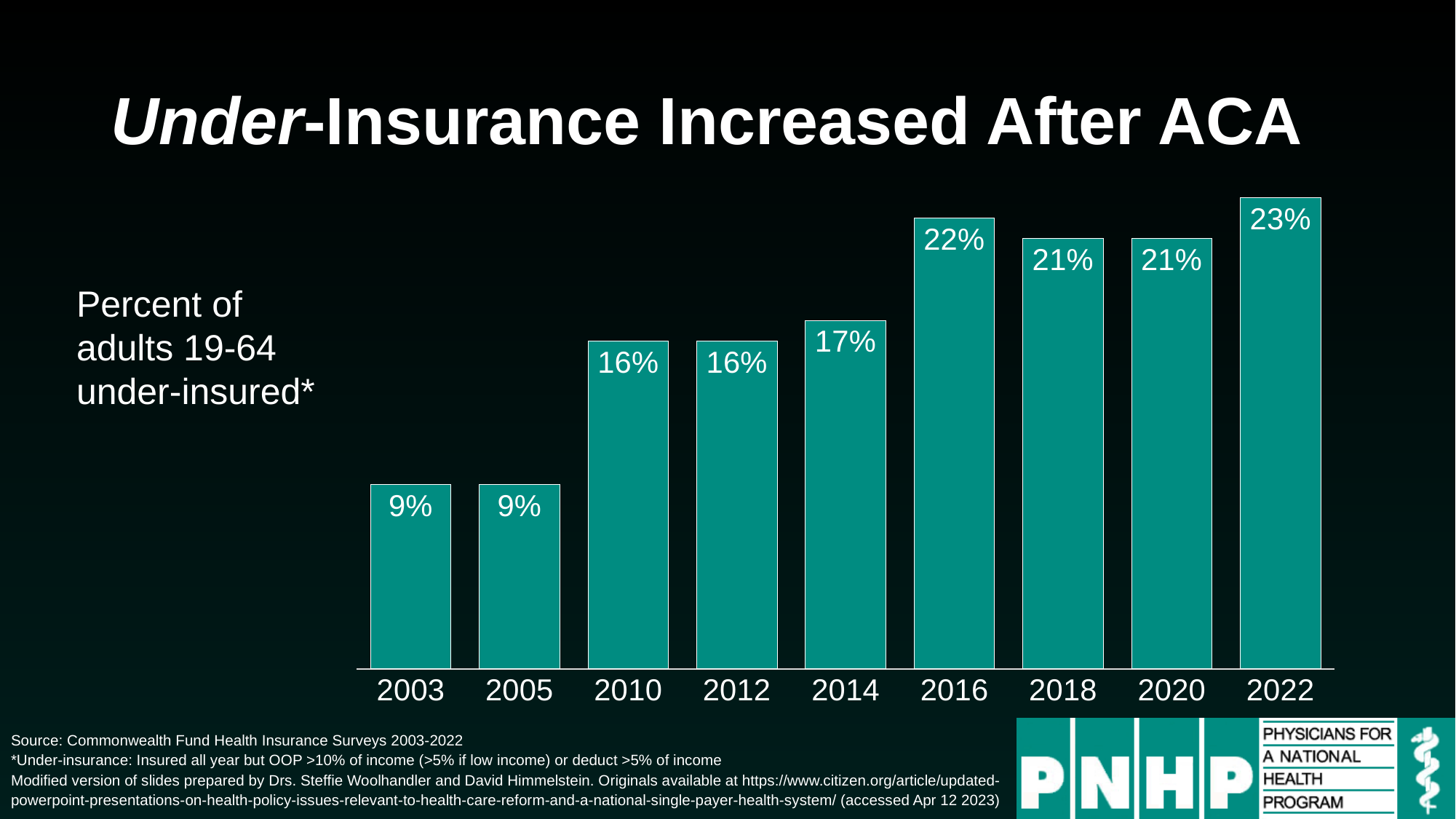
What is the title of the slide? Under-Insurance Increased After ACA Which is larger, the value for 2016 or the value for 2018? 2016 Do the values generally rise or fall from 2003 to 2022? Rise What percent of adults 19-64 were under-insured in 2003? 9% What is the difference between the values for 2016 and 2014? 5% How many years are shown on the x axis? 9 What kind of chart is shown on the slide? Bar chart What is the difference between the values for 2022 and 2003? 14% What is the value shown for 2016? 22% What is the value shown for 2014? 17% Which two years share the same value of 21%? 2018 and 2020 Which year has the highest percent of under-insured adults? 2022